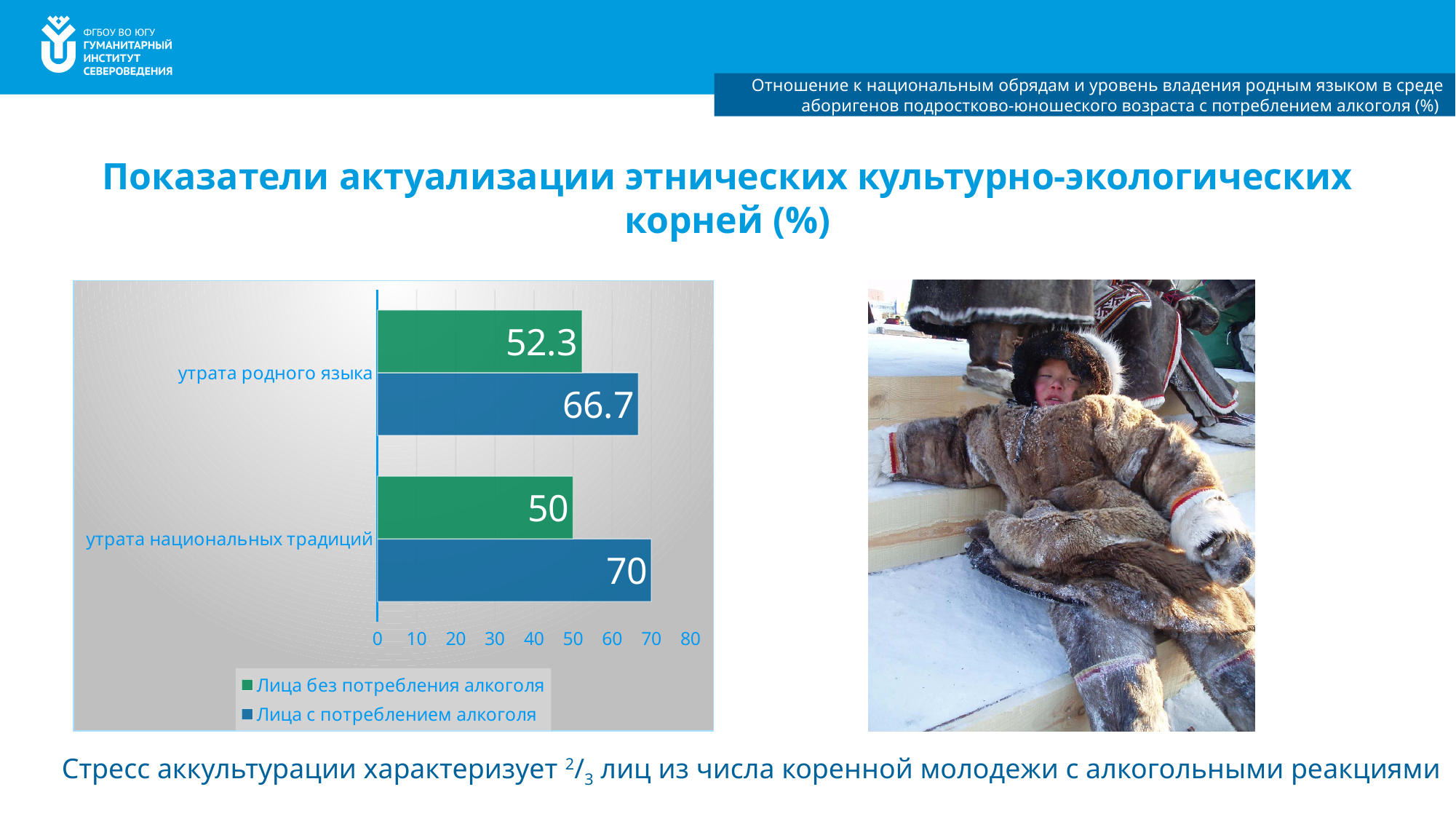
Which category has the highest value for the series «Лица с потреблением алкоголя»? утрата национальных традиций In the category «утрата родного языка», which series has the larger value? Лица с потреблением алкоголя What is the difference between the two series in the category «утрата родного языка»? 14.4 What is the value for «Лица без потребления алкоголя» in the category «утрата родного языка»? 52.3 What kind of chart is shown on the slide? bar chart How many series does the legend list? 2 What is the difference between the two series in the category «утрата национальных традиций»? 20 Which category has the lowest value for the series «Лица без потребления алкоголя»? утрата национальных традиций How many categories are shown on the chart? 2 What is the value for «Лица без потребления алкоголя» in the category «утрата национальных традиций»? 50 What is the value for «Лица с потреблением алкоголя» in the category «утрата родного языка»? 66.7 What is the value for «Лица с потреблением алкоголя» in the category «утрата национальных традиций»? 70